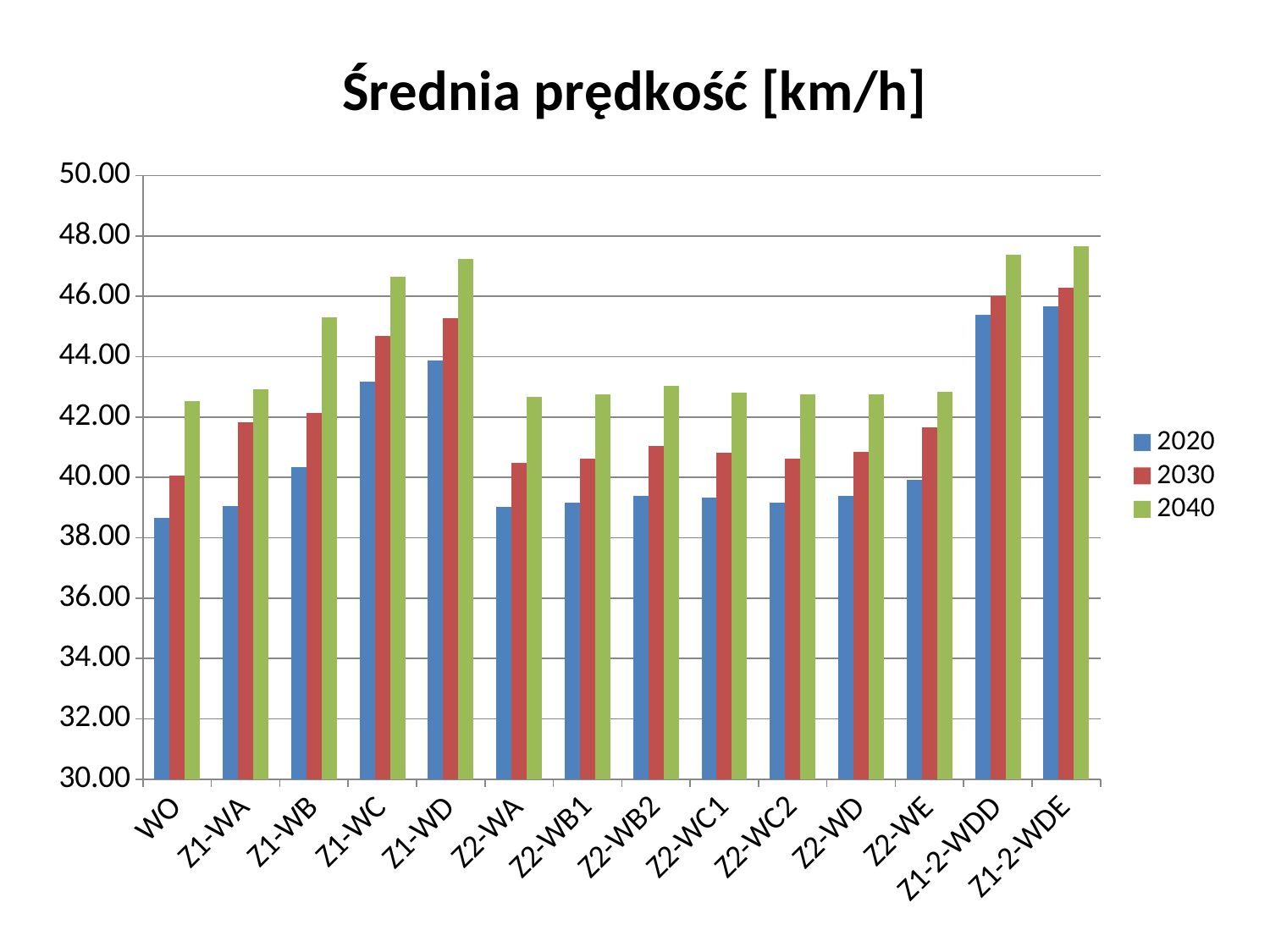
Is the 2040 value for Z1-WC greater or less than 46.00? greater Within each category, do the values rise or fall from 2020 to 2040? rise What is the title of the chart? Średnia prędkość [km/h] Is the 2040 value for Z2-WA greater or less than 44.00? less How many categories are shown on the x axis? 14 How many series does the legend list? 3 Is the 2030 value for WO greater or less than 42.00? less Which is larger, the 2020 value for Z1-WC or the 2020 value for Z2-WE? Z1-WC Which is larger, the 2040 value for Z1-WD or the 2040 value for Z1-WC? Z1-WD What kind of chart is shown on the slide? bar chart